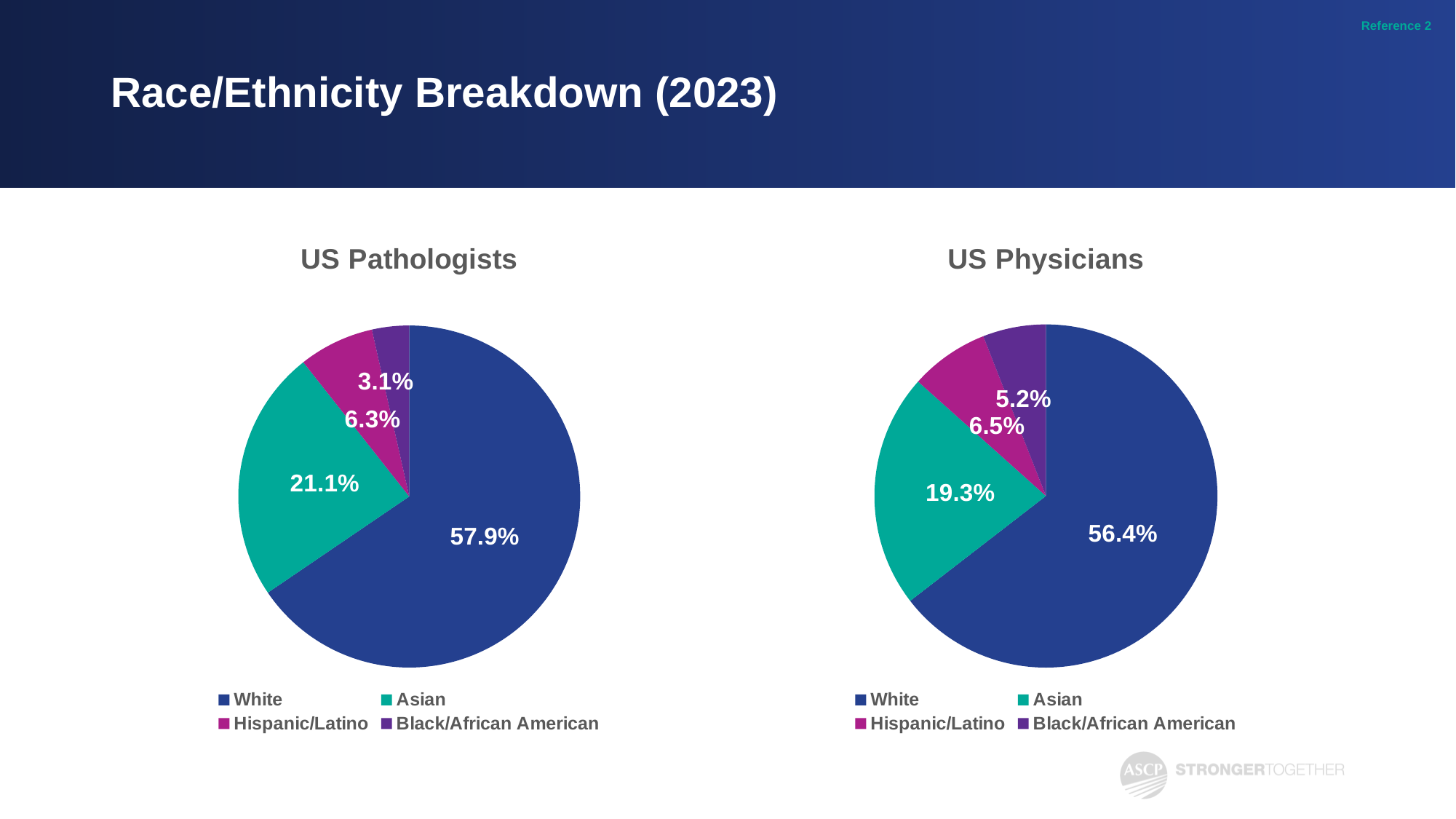
In the US Pathologists pie chart, what share is Asian? 21.1% Is the Asian share larger in the US Pathologists chart or the US Physicians chart? US Pathologists In the US Physicians pie chart, which category has the largest share? White What is the difference between the White share in the US Pathologists chart and the White share in the US Physicians chart? 1.5% In the US Pathologists chart, which colour represents Asian? Teal In the US Physicians pie chart, what share is Black/African American? 5.2% In the US Pathologists pie chart, which category has the smallest share? Black/African American In the US Pathologists pie chart, what share is White? 57.9% In the US Physicians pie chart, what share is Hispanic/Latino? 6.5% How many categories does the US Physicians pie chart show? 4 In the US Pathologists pie chart, what share is Black/African American? 3.1% What type of chart is used for US Pathologists? Pie chart